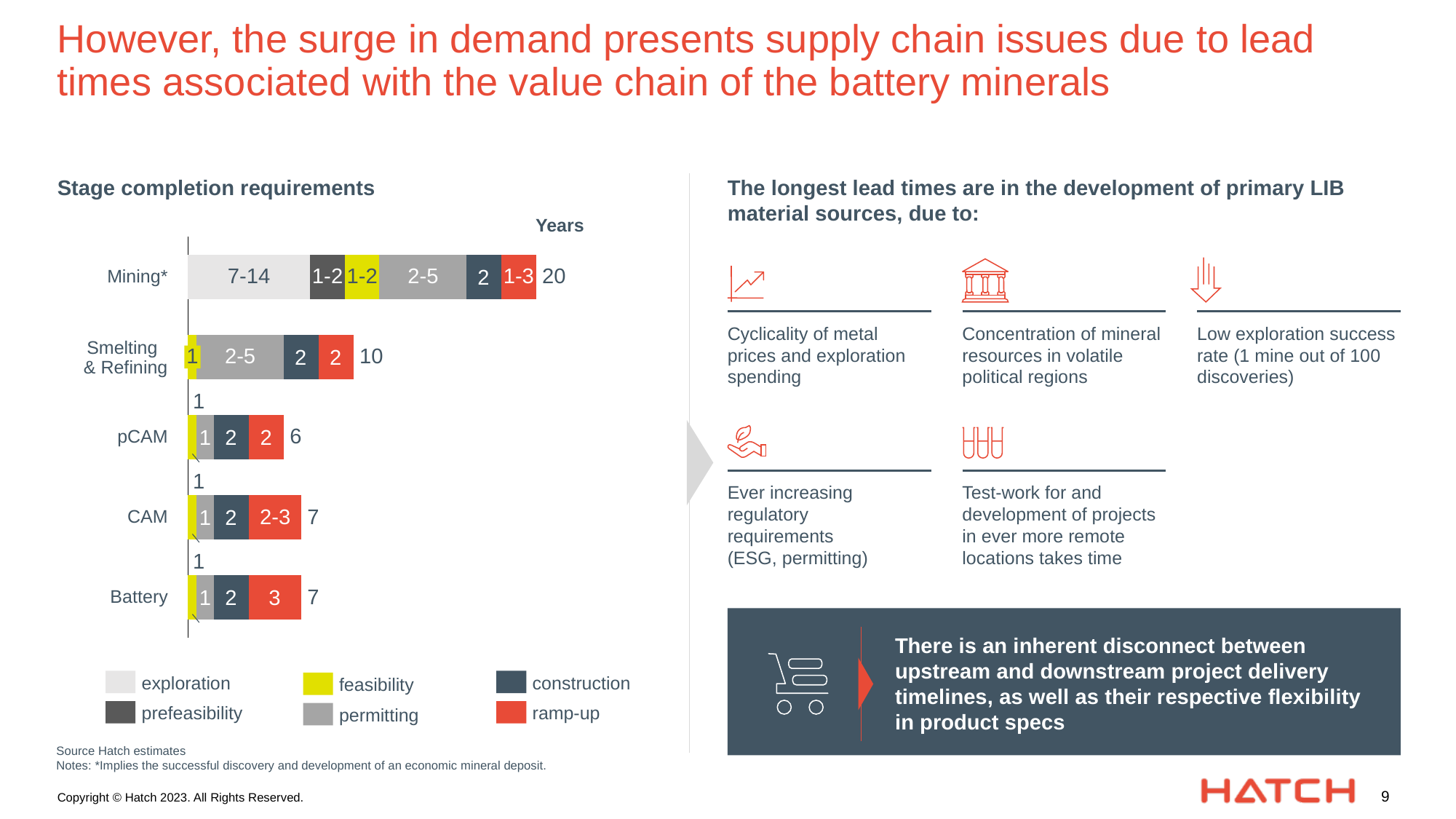
Which stage has the longest total lead time in the 'Stage completion requirements' chart? Mining* What is the total number of years shown for Smelting & Refining? 10 What is the exploration value shown for Mining*? 7-14 What kind of chart is the 'Stage completion requirements' chart? Stacked bar chart Which stage has the shortest total lead time in the 'Stage completion requirements' chart? pCAM What is the total number of years shown for Mining* in the 'Stage completion requirements' chart? 20 What is the ramp-up value shown for Battery? 3 What is the difference in total years between Mining* and Smelting & Refining? 10 How many stages (categories) are shown in the 'Stage completion requirements' chart? 5 How many series does the legend of the 'Stage completion requirements' chart list? 6 What is the ramp-up value shown for CAM? 2-3 Which colour represents ramp-up in the legend of the 'Stage completion requirements' chart? Red